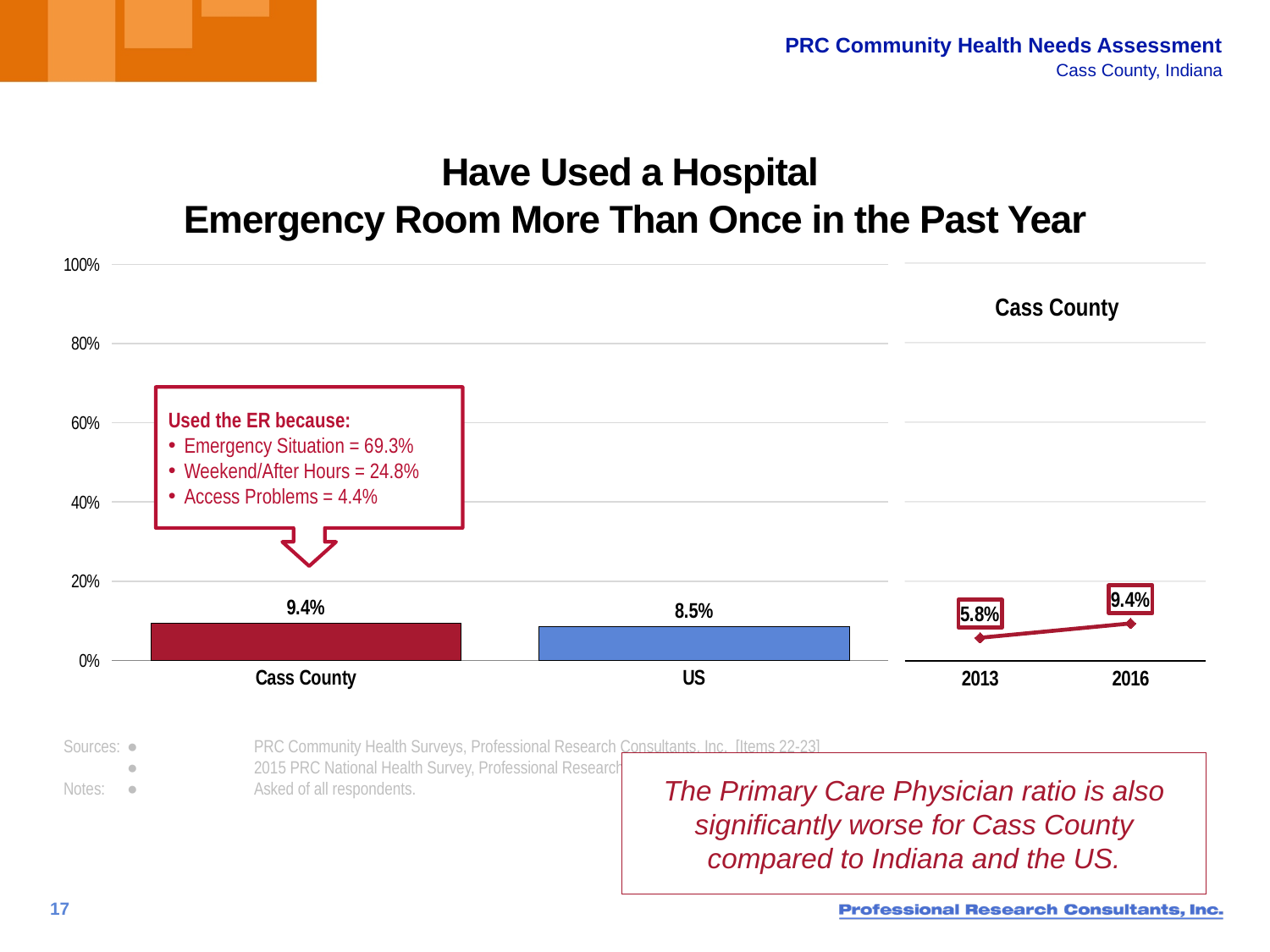
In the bar chart on the left, what is the difference between the Cass County value and the US value? 0.9% In the bar chart on the left, what is the value for US? 8.5% What is the title of the chart on the slide? Have Used a Hospital Emergency Room More Than Once in the Past Year In the Cass County trend chart on the right, what is the value for 2016? 9.4% In the bar chart on the left, which category has the higher value, Cass County or US? Cass County In the Cass County trend chart on the right, what is the value for 2013? 5.8% What kind of chart is the chart on the left comparing Cass County and US? bar chart In the bar chart on the left, is the value for US greater or less than 20%? less In the Cass County trend chart on the right, does the value rise or fall from 2013 to 2016? rise In the Cass County trend chart on the right, what is the difference between the 2016 and 2013 values? 3.6% In the bar chart on the left, what is the value for Cass County? 9.4% In the bar chart on the left, how many categories are shown? 2